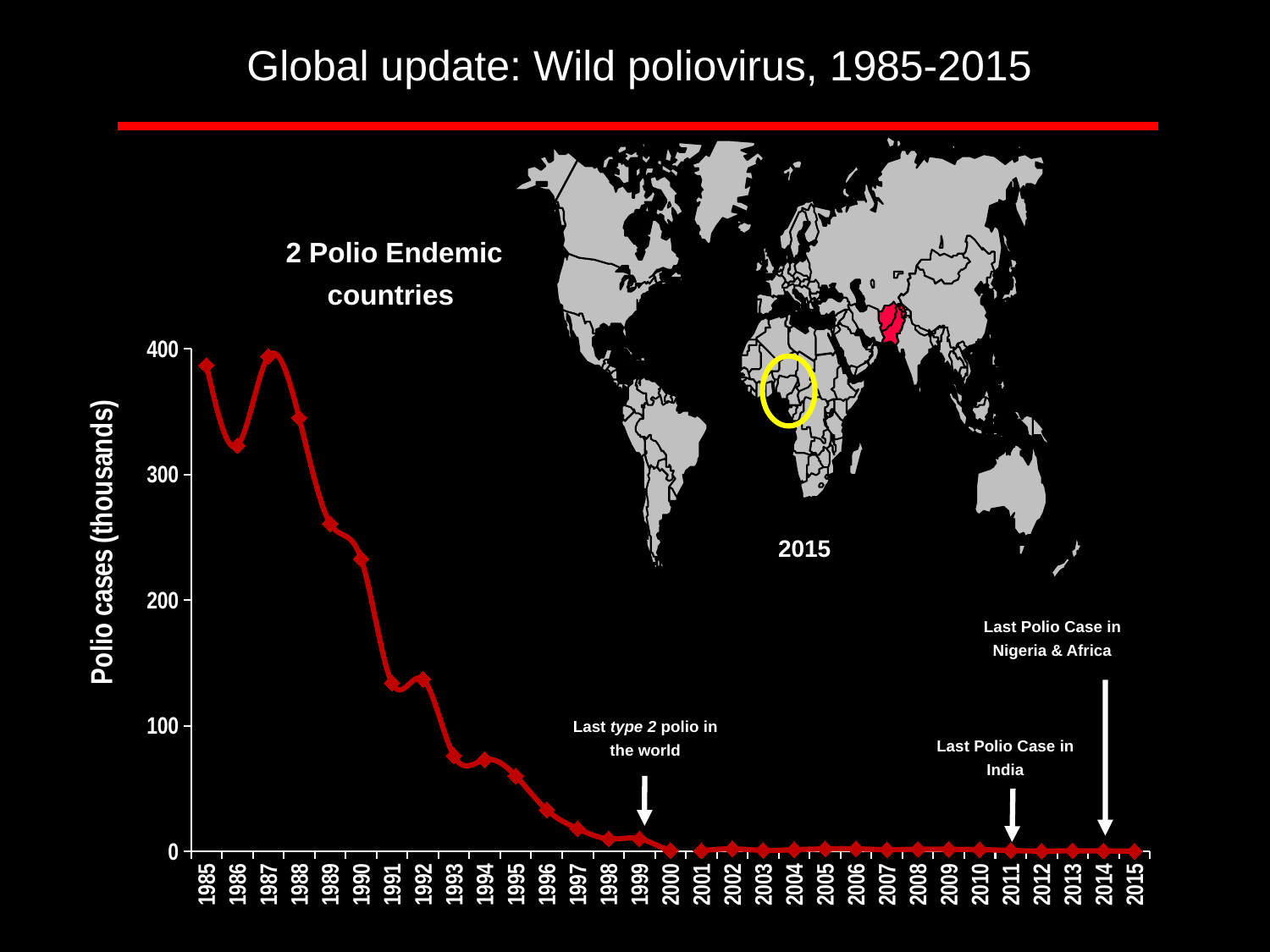
Which year is annotated as the last polio case in India? 2011 What is the label on the y axis of the chart? Polio cases (thousands) What kind of chart is shown on the slide? line chart Do polio cases generally rise or fall from 1985 to 2015? fall Is the value for 1996 greater or less than 100? less Is the value for 1991 greater or less than 100? greater Which year has the larger value, 1985 or 1986? 1985 Which year has the larger value, 1989 or 1990? 1989 Is the value for 1986 greater or less than 300? greater How many years are plotted on the x axis of the chart? 31